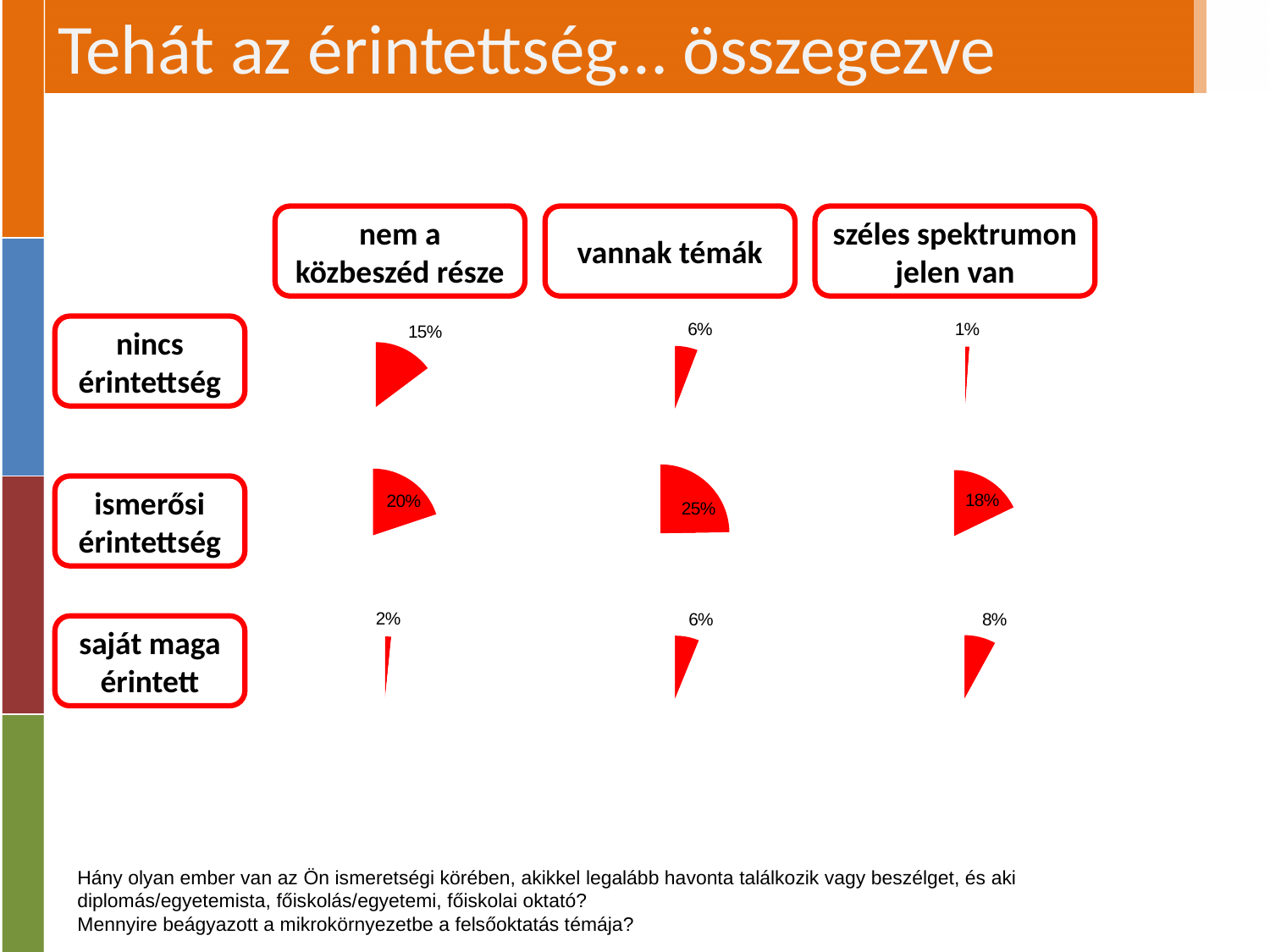
What is the total of the three percentages in the 'ismerősi érintettség' row? 63% What colour are the pie slices on the slide? red What is the difference between the 'ismerősi érintettség' values in the 'nem a közbeszéd része' and 'széles spektrumon jelen van' columns? 2% What percentage is shown for 'saját maga érintett' in the 'széles spektrumon jelen van' column? 8% What kind of chart is used to show each percentage on the slide? pie chart How many small pie charts are shown on the slide? 9 Which column has the lowest percentage in the 'saját maga érintett' row? nem a közbeszéd része Which is larger: the 'nincs érintettség' value for 'nem a közbeszéd része' or the 'saját maga érintett' value for 'széles spektrumon jelen van'? nincs érintettség for nem a közbeszéd része What percentage is shown for 'nincs érintettség' in the 'nem a közbeszéd része' column? 15% What percentage is shown for 'nincs érintettség' in the 'széles spektrumon jelen van' column? 1% Which row has the highest percentage in the 'vannak témák' column? ismerősi érintettség What percentage is shown for 'ismerősi érintettség' in the 'vannak témák' column? 25%